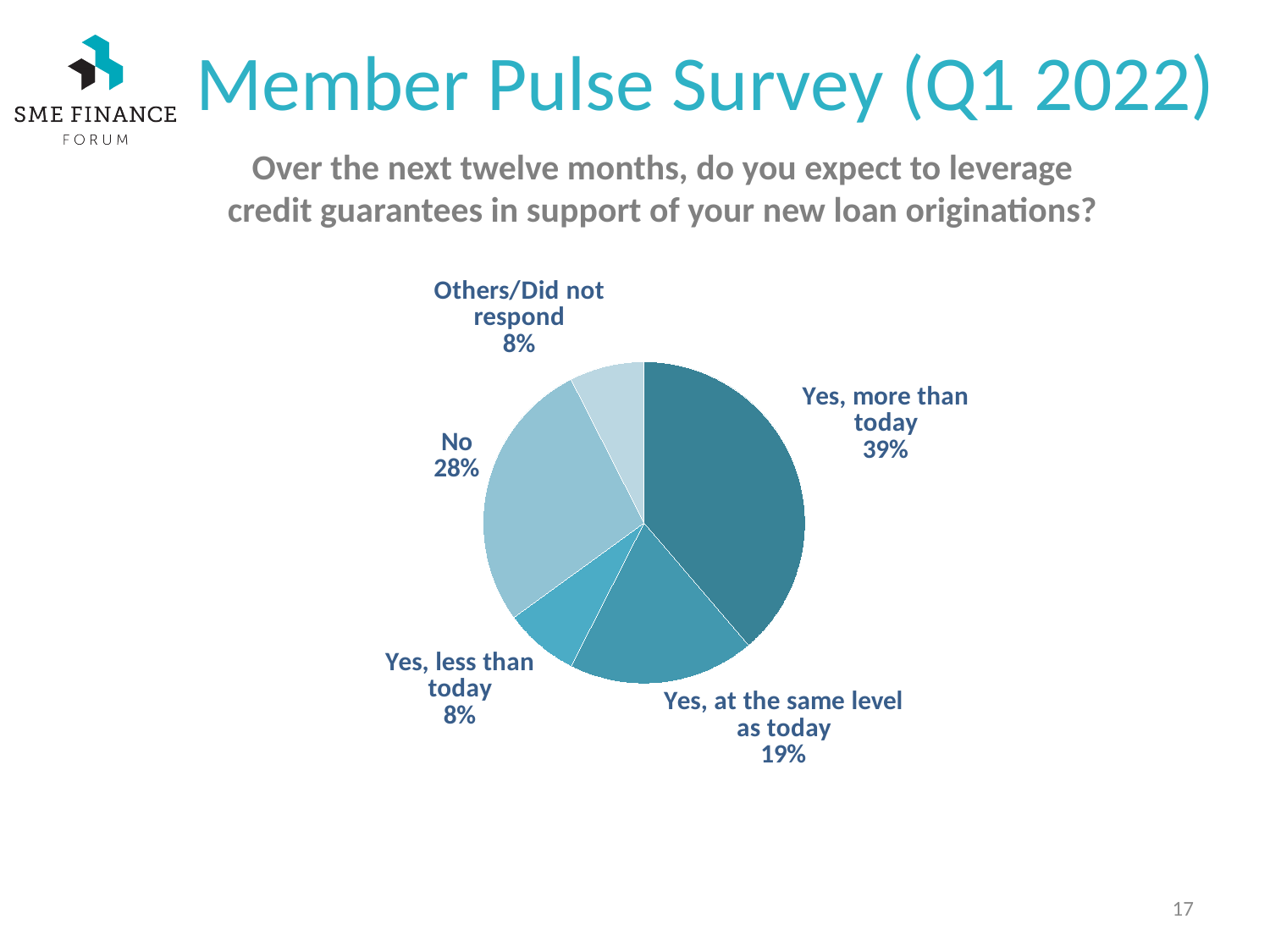
What is the combined share of all three "Yes" responses? 66% What kind of chart is shown on the slide? Pie chart What is the difference in percentage points between "Yes, more than today" and "No"? 11 percentage points How many slices does the pie chart have? 5 Which is larger: the share for "No" or the share for "Yes, at the same level as today"? No What share of respondents answered "Yes, less than today"? 8% What share of respondents answered "Yes, at the same level as today"? 19% What share of respondents answered "No"? 28% What survey question does the pie chart answer? Over the next twelve months, do you expect to leverage credit guarantees in support of your new loan originations? Which response has the largest share of the pie? Yes, more than today What share of respondents fall under "Others/Did not respond"? 8% What share of respondents answered "Yes, more than today"? 39%